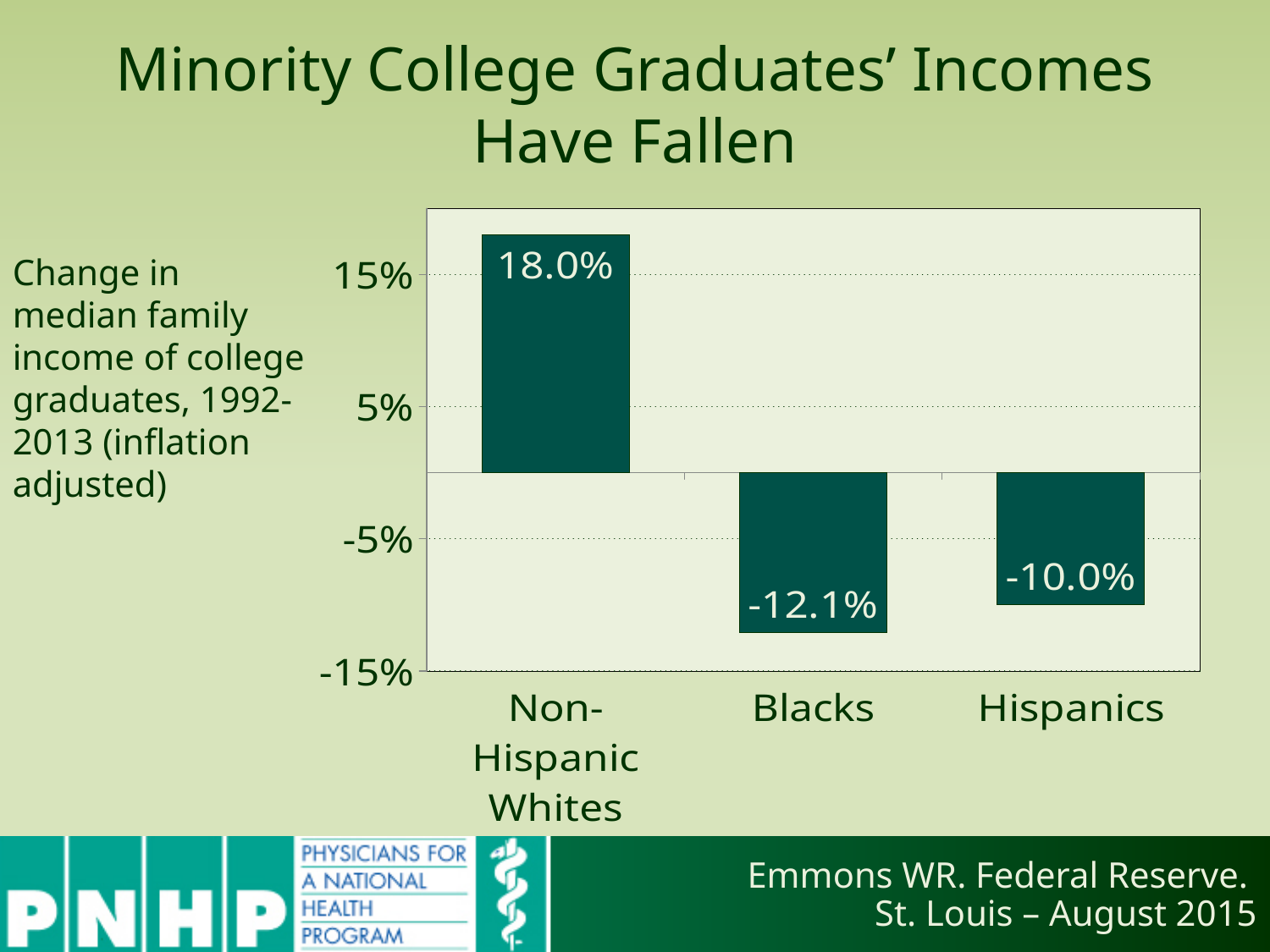
What is the value for Hispanics? -10.0% Which is larger, the value for Blacks or the value for Hispanics? Hispanics Which category has the lowest value? Blacks What is the difference between the values for Hispanics and Blacks? 2.1 percentage points What kind of chart is shown on the slide? Bar chart How many categories are shown on the chart? 3 Is the value for Non-Hispanic Whites greater or less than 15%? greater What is the title of the slide? Minority College Graduates' Incomes Have Fallen What is the value for Blacks? -12.1% Which category has the highest value? Non-Hispanic Whites What is the difference between the values for Non-Hispanic Whites and Blacks? 30.1 percentage points What is the value for Non-Hispanic Whites? 18.0%